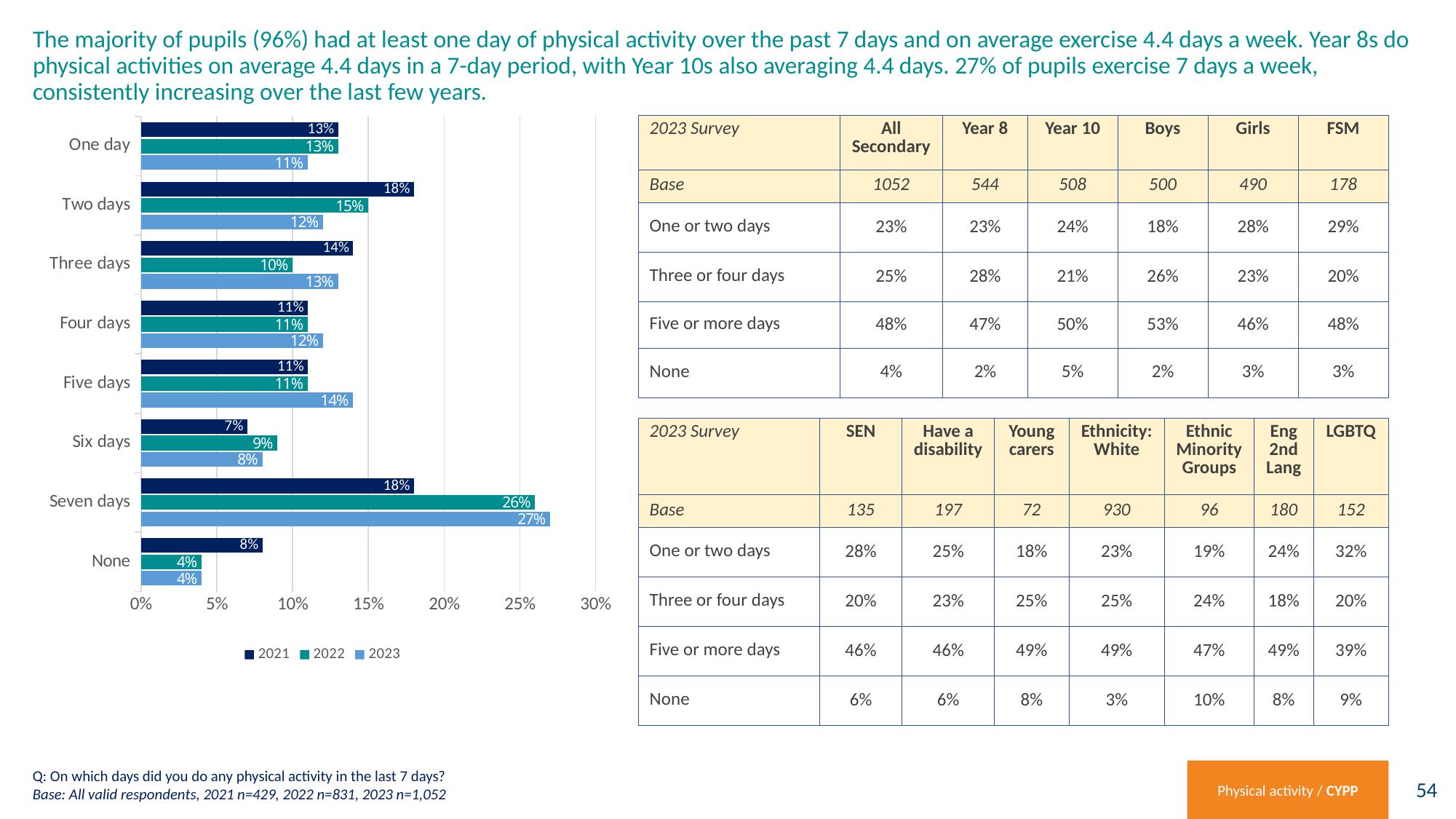
What is the 2023 value for Seven days? 27% What is the difference between the 2022 and 2021 values for Seven days? 8% How many categories are shown on the chart's vertical axis? 8 Which category has the lowest 2023 value? None Is the 2023 value for Seven days greater or less than 25%? greater Which category has the highest 2022 value? Seven days What kind of chart is shown on the slide? bar chart What is the 2022 value for Three days? 10% Which is larger for Two days, the 2021 value or the 2023 value? 2021 Which series in the legend is shown in the darkest blue colour? 2021 How many series does the chart legend list? 3 What is the 2021 value for Two days? 18%